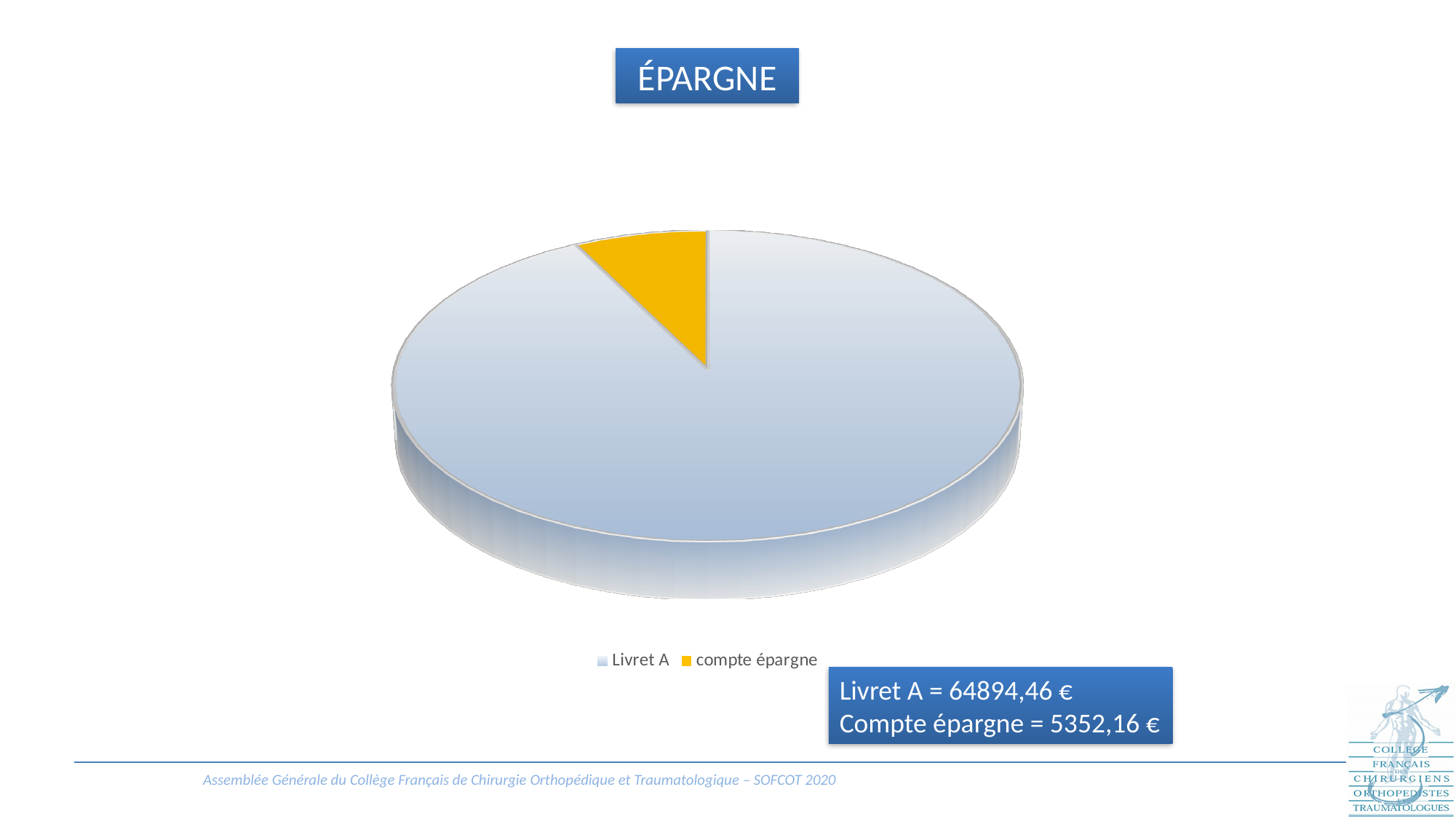
What is the total of Livret A and Compte épargne? 70246,62 € What colour is the compte épargne slice? yellow How many slices does the pie chart have? 2 Which category has the largest slice of the pie? Livret A What is the title of the chart? ÉPARGNE What is the difference between Livret A and Compte épargne? 59542,30 € What kind of chart is shown on the slide? pie chart What is the value for Livret A? 64894,46 € Which category has the smallest slice of the pie? compte épargne Which is larger, Livret A or Compte épargne? Livret A What is the value for Compte épargne? 5352,16 € How many series does the legend list? 2